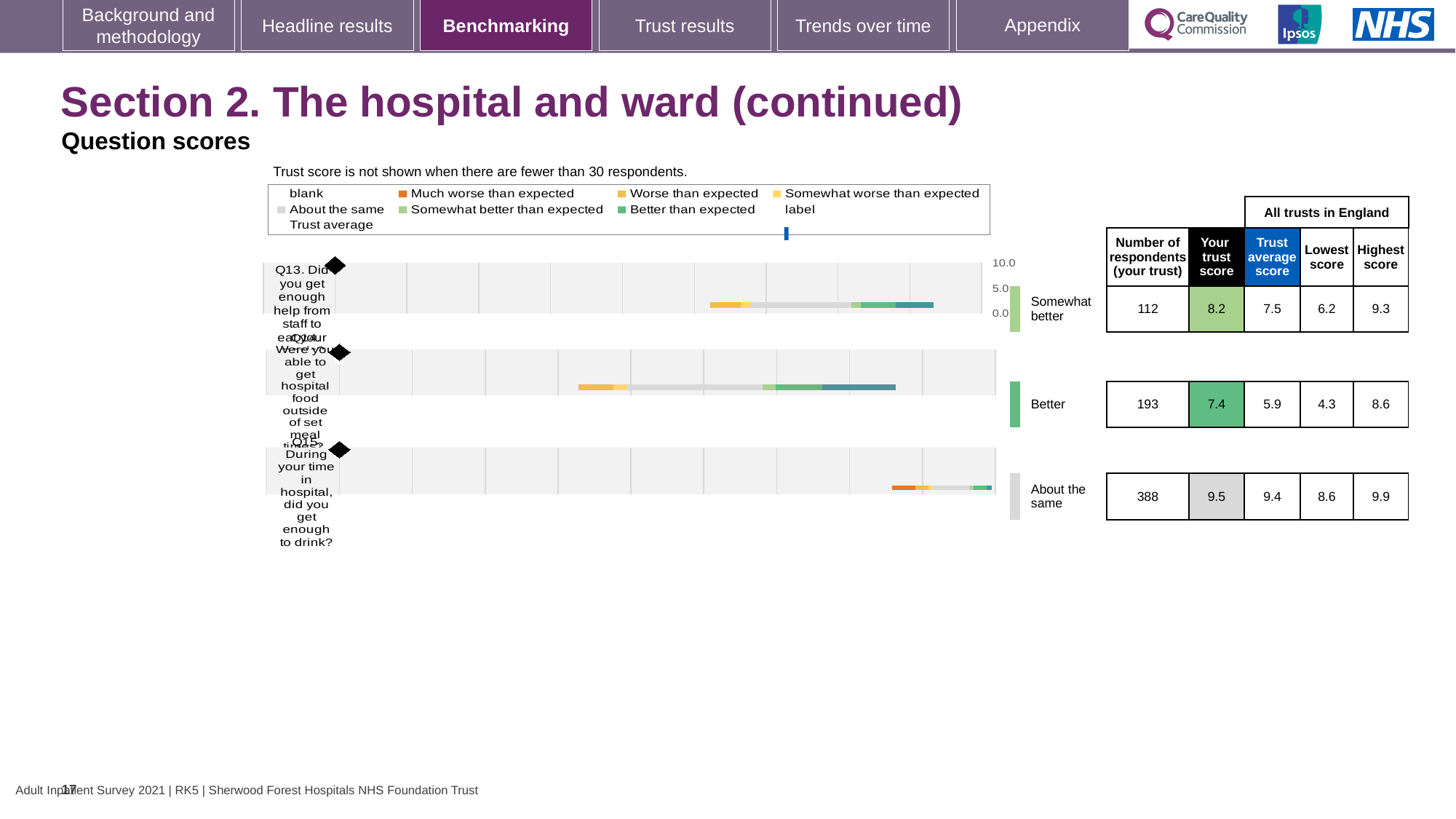
For Q14, which is larger: the trust score or the trust average score? Trust score What is the trust average score for Q15 (enough to drink)? 9.4 How many questions (bars) are plotted on the slide? 3 How many respondents answered Q14 (hospital food outside of set meal times)? 193 What benchmark category is shown for Q14? Better According to the note above the chart, when is the trust score not shown? When there are fewer than 30 respondents What is the difference between the trust score and the trust average score for Q13? 0.7 Which question has the highest trust score? Q15 What is the highest score across all trusts in England for Q13? 9.3 What is the trust score for Q13 (help from staff to eat meals)? 8.2 What kind of chart is used to show the question scores on this slide? Bar chart Which question has the lowest trust score? Q14